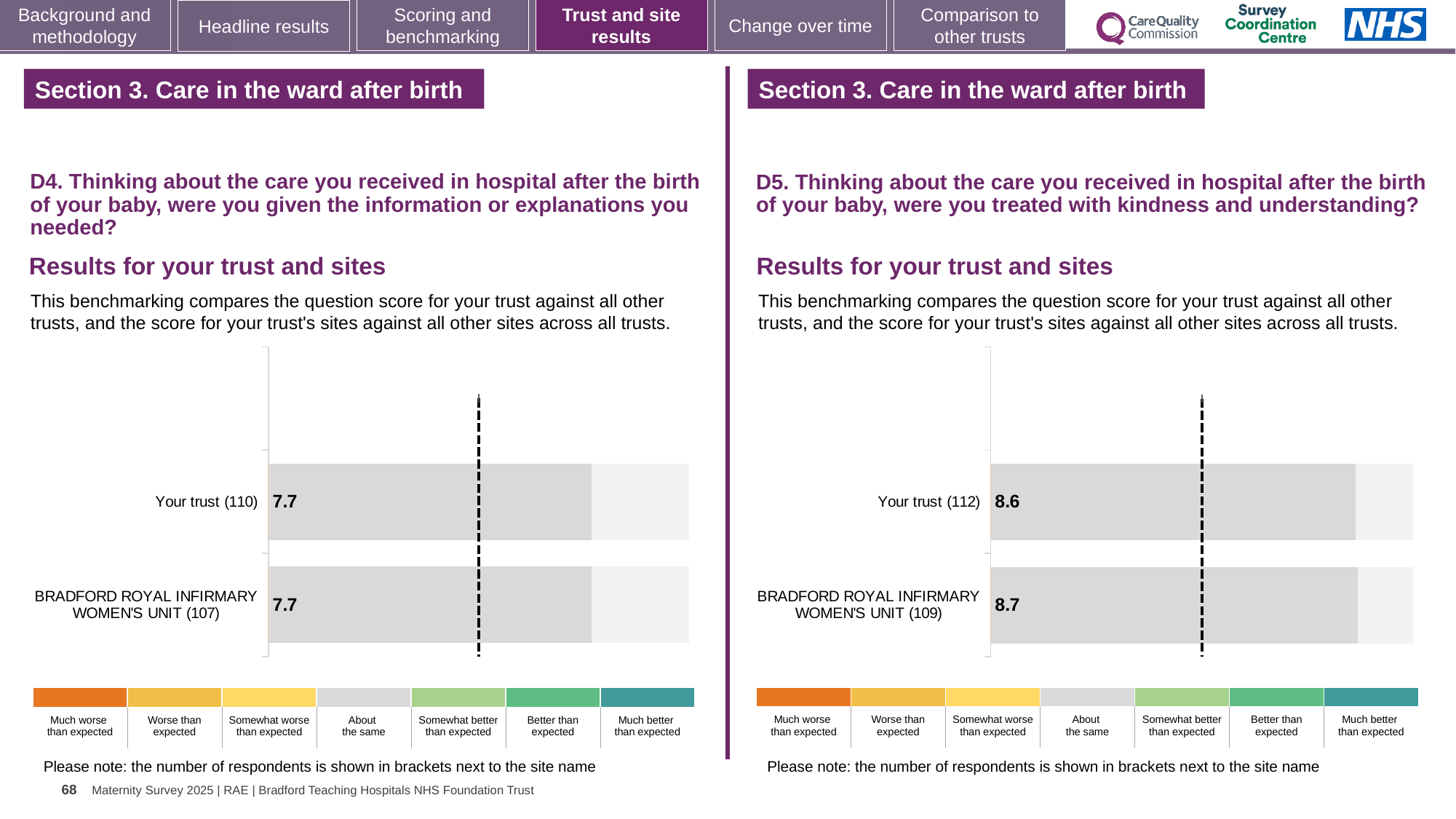
In the D4 chart on the left, what is the difference between the score for Your trust and the score for BRADFORD ROYAL INFIRMARY WOMEN'S UNIT? 0 In the D5 chart on the right, what is the score for Your trust (112)? 8.6 How many bars are plotted in the D5 chart on the right? 2 What type of chart is used for the D4 results on the left? Bar chart In the D4 chart on the left, what is the score for BRADFORD ROYAL INFIRMARY WOMEN'S UNIT (107)? 7.7 In the D5 chart on the right, how many respondents are shown in brackets for BRADFORD ROYAL INFIRMARY WOMEN'S UNIT? 109 In the D4 chart on the left, how many respondents are shown in brackets for Your trust? 110 How many bars are plotted in the D4 chart on the left? 2 In the D4 chart on the left, what is the score for Your trust (110)? 7.7 In the D5 chart on the right, which has the higher score: Your trust or BRADFORD ROYAL INFIRMARY WOMEN'S UNIT? BRADFORD ROYAL INFIRMARY WOMEN'S UNIT In the D5 chart on the right, what is the score for BRADFORD ROYAL INFIRMARY WOMEN'S UNIT (109)? 8.7 In the D5 chart on the right, what is the difference between the score for BRADFORD ROYAL INFIRMARY WOMEN'S UNIT and the score for Your trust? 0.1